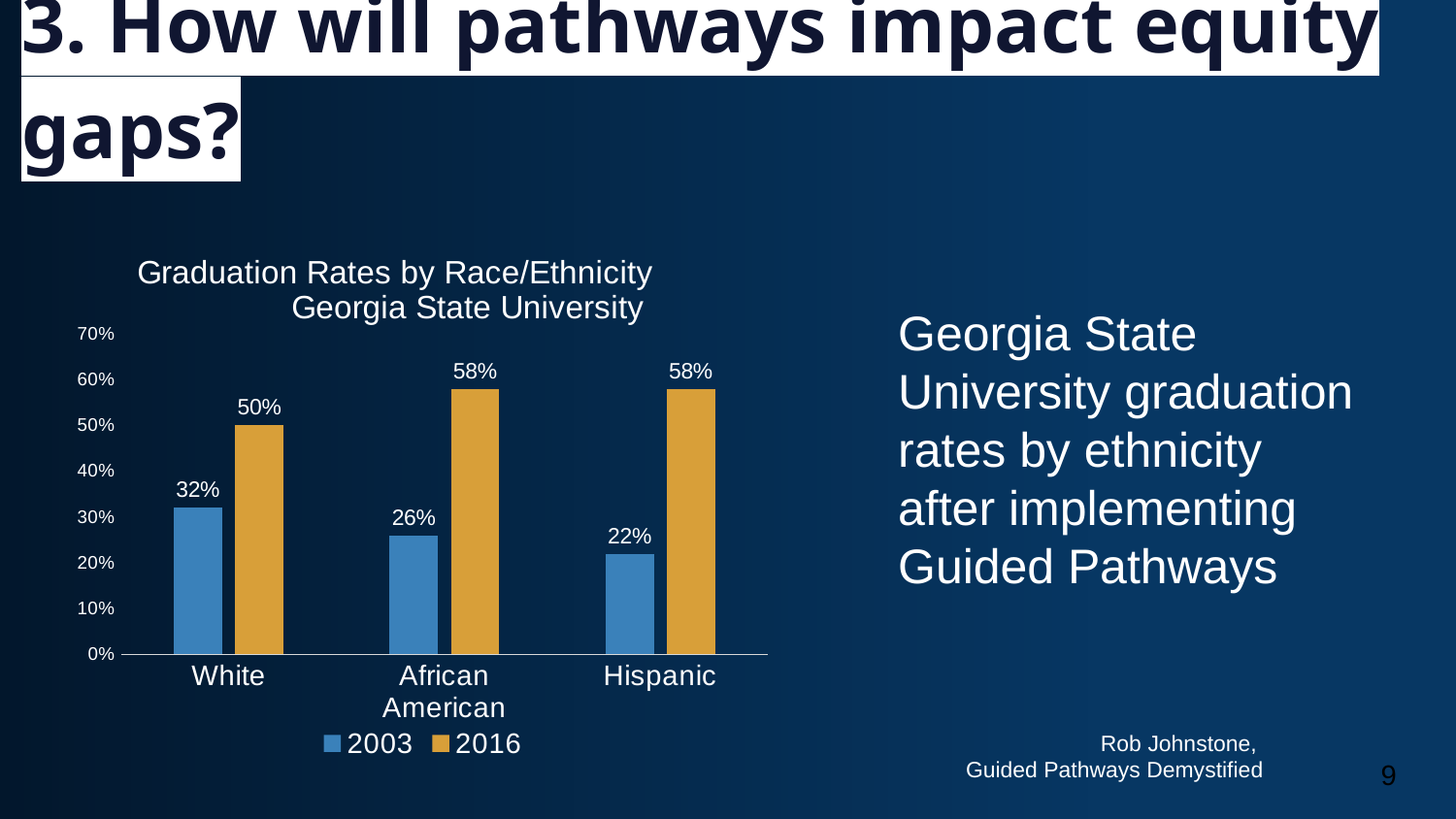
What was the graduation rate for African American students in 2003? 26% Which is larger: the 2016 graduation rate for White students or for African American students? African American How many series does the legend list? 2 Which race/ethnicity group had the highest graduation rate in 2003? White How many race/ethnicity categories are shown on the chart? 3 By how many percentage points did the graduation rate for Hispanic students increase from 2003 to 2016? 36 percentage points What was the graduation rate for White students in 2003? 32% What was the graduation rate for Hispanic students in 2016? 58% What is the title of the chart? Graduation Rates by Race/Ethnicity Georgia State University What type of chart is shown on the slide? Bar chart Which race/ethnicity group had the lowest graduation rate in 2003? Hispanic What is the difference between the 2016 graduation rates for African American and White students? 8 percentage points